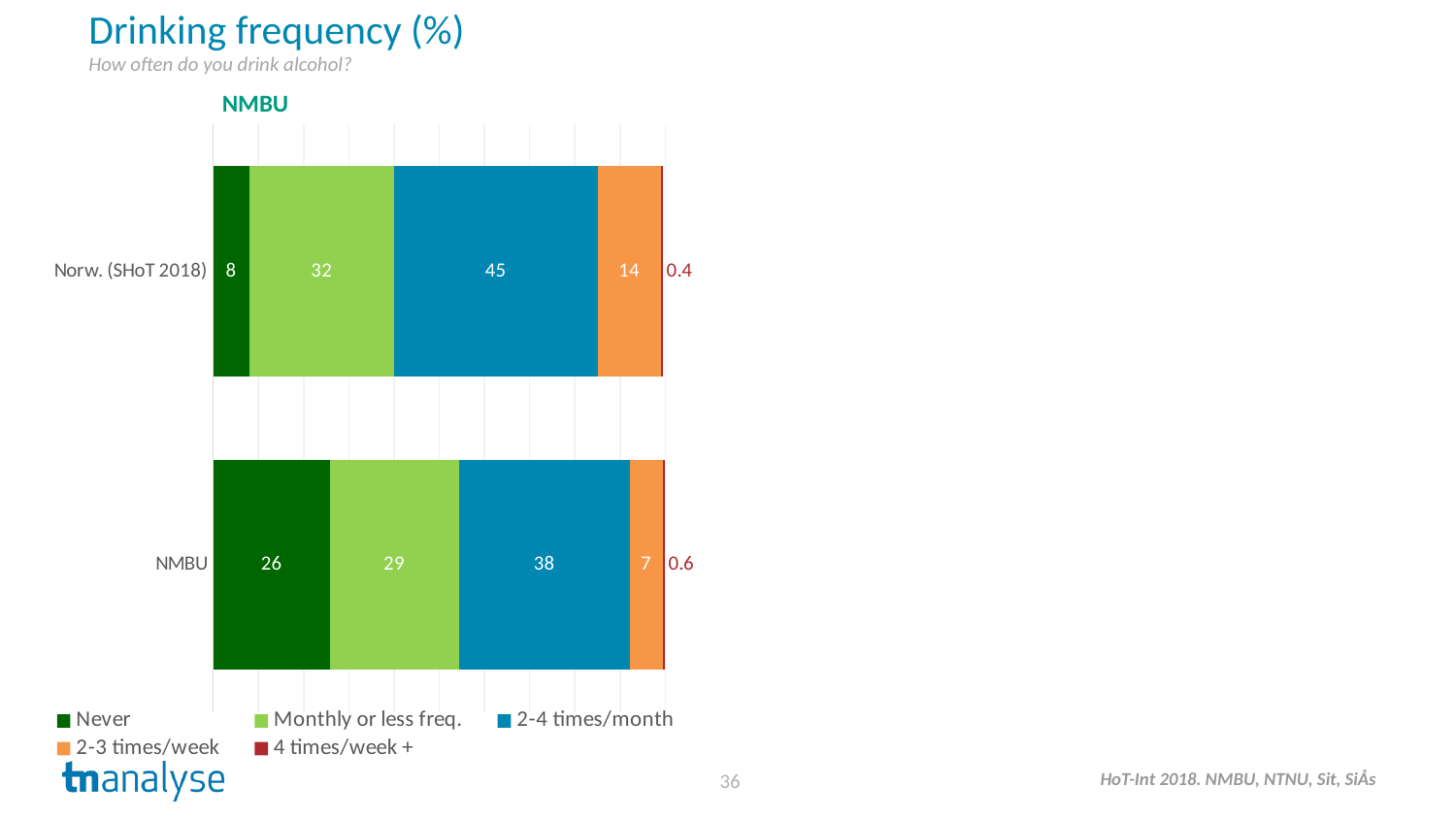
How many categories (bars) are plotted in the chart? 2 What is the value for '4 times/week +' for NMBU? 0.6 What is the value for '2-3 times/week' for Norw. (SHoT 2018)? 14 Which category has the higher value for 'Never', NMBU or Norw. (SHoT 2018)? NMBU What kind of chart is shown on the slide? Stacked bar chart What is the difference between the '2-4 times/month' values for Norw. (SHoT 2018) and NMBU? 7 What is the value for 'Never' for NMBU? 26 What is the value for '2-4 times/month' for Norw. (SHoT 2018)? 45 How many series does the legend list? 5 What is the title of the chart? Drinking frequency (%) Which series has the largest value within the NMBU bar? 2-4 times/month What is the difference between the 'Never' values for NMBU and Norw. (SHoT 2018)? 18